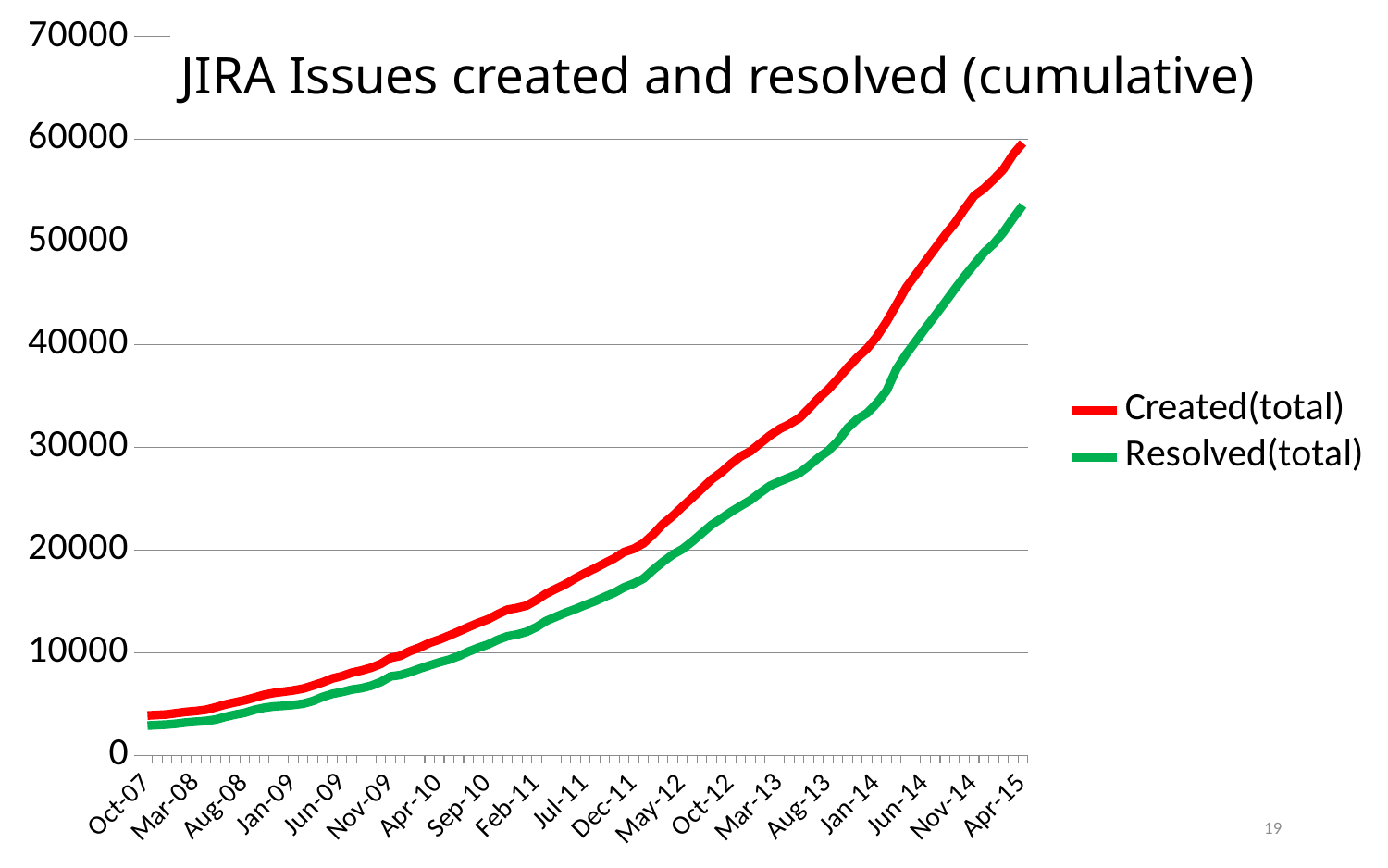
What is the title of the chart? JIRA Issues created and resolved (cumulative) Is the Resolved(total) value at Apr-15 greater or less than 50000? greater At Apr-15, which series has the larger value, Created(total) or Resolved(total)? Created(total) Is the Resolved(total) value at Dec-11 greater or less than 20000? less Is the Created(total) value at Jun-14 greater or less than 40000? greater How many series does the legend list? 2 Do the Created(total) values rise or fall from Oct-07 to Apr-15? rise What kind of chart is shown on the slide? line chart Which colour is used for the Resolved(total) series? green